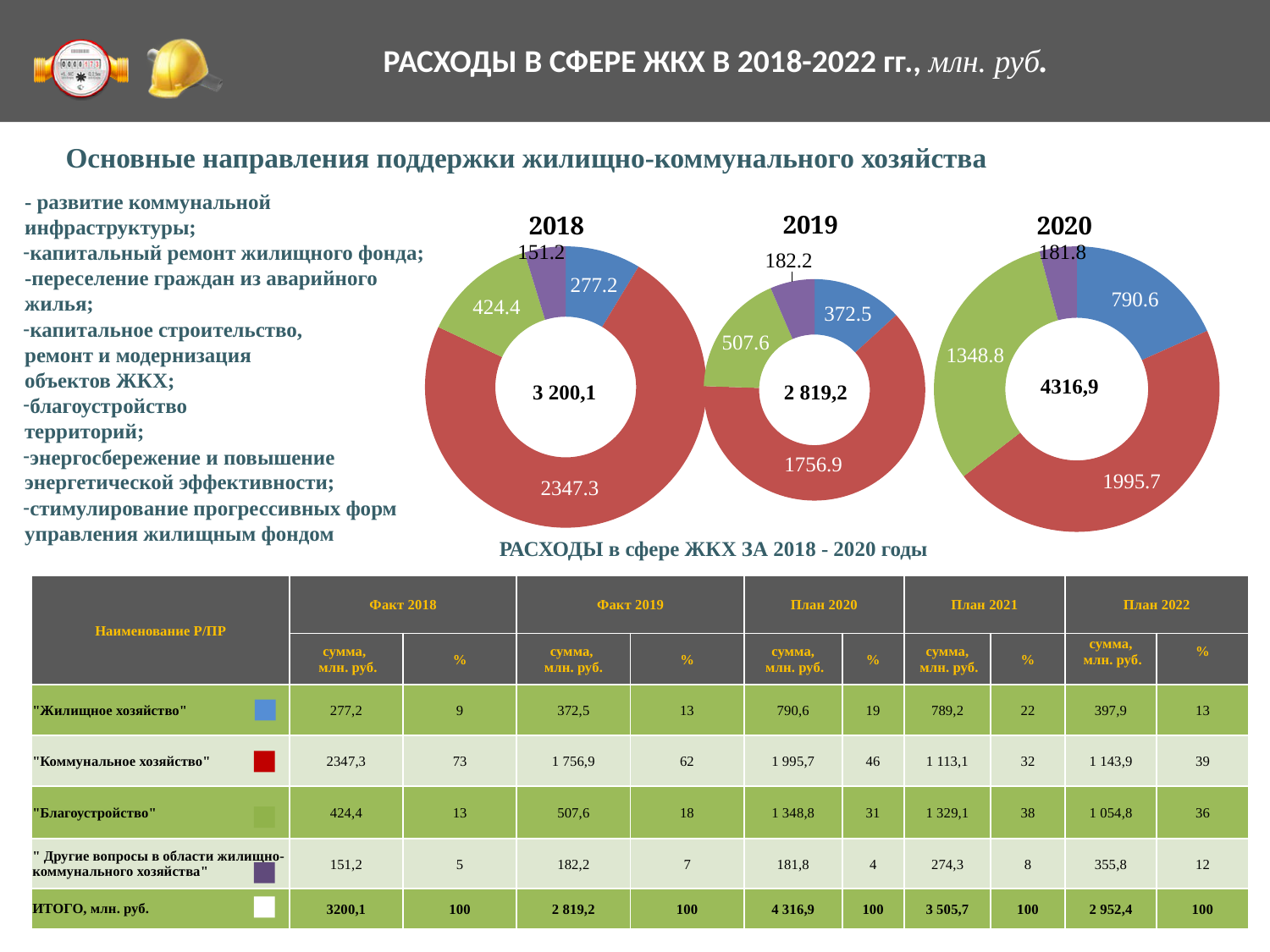
In the 2019 doughnut chart, what is the smallest segment value? 182.2 What type of chart is used to show the housing and utilities expenses for 2018, 2019 and 2020? Pie chart (doughnut) How many segments does each doughnut chart contain? 4 In the 2020 doughnut chart, what is the value of the blue segment? 790.6 In the 2018 doughnut chart, what is the value of the largest (red) segment? 2347.3 Does the value of the green segment rise or fall from the 2018 chart to the 2020 chart? Rises (424.4, 507.6, 1348.8) In the 2019 doughnut chart, what is the value of the green segment? 507.6 In the 2020 doughnut chart, which segment has the largest value? The red segment, 1995.7 How many doughnut charts are shown on the slide? 3 What is the difference between the green segment in the 2020 chart (1348.8) and the green segment in the 2019 chart (507.6)? 841.2 What total is shown in the centre of the 2018 doughnut chart? 3 200,1 Which is larger: the blue segment in the 2018 chart or the blue segment in the 2019 chart? The 2019 chart (372.5 vs 277.2)